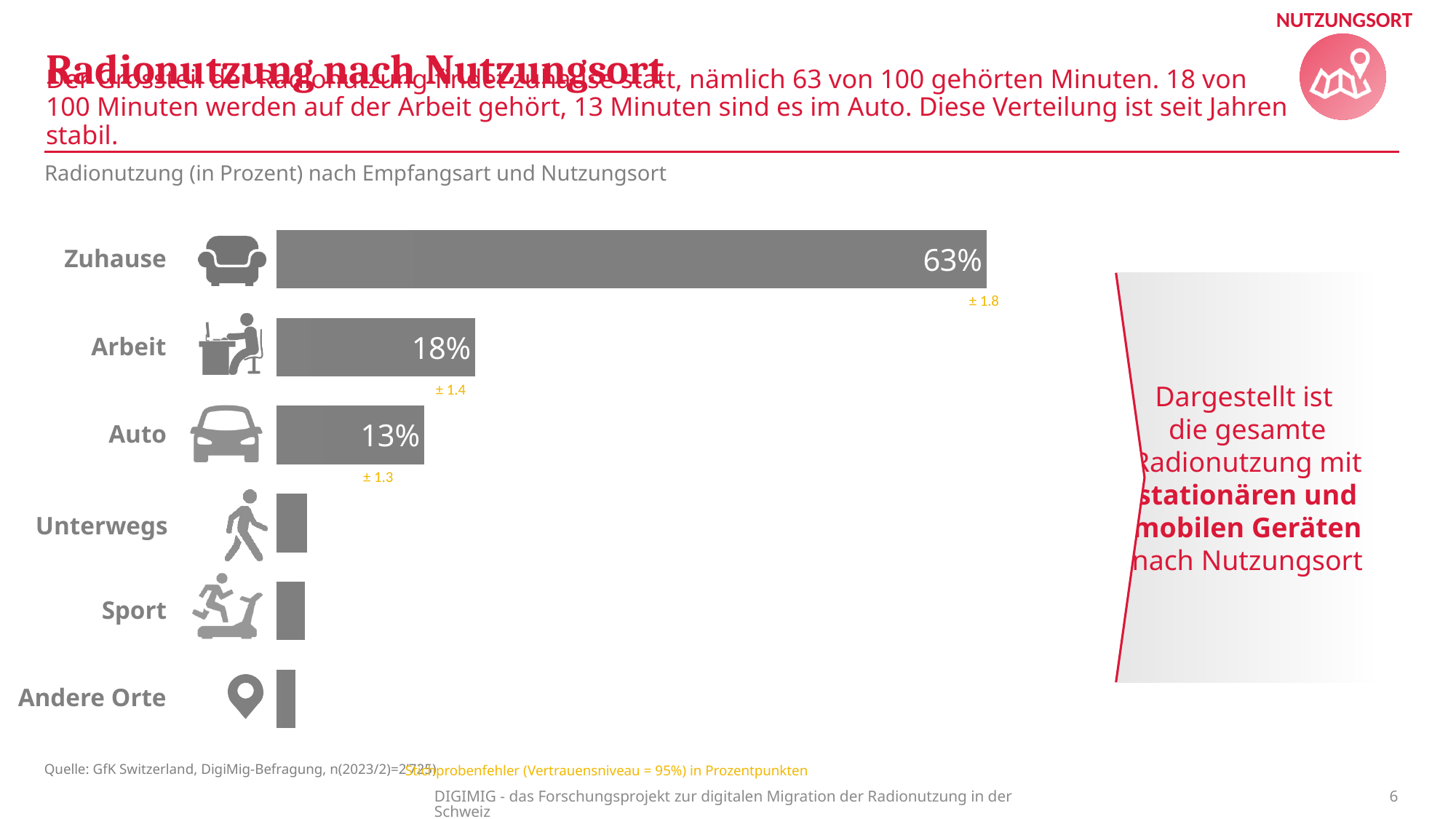
What is the sampling error (±) shown for the Zuhause bar? ± 1.8 Which category has the highest value? Zuhause Which is larger, the value for Arbeit or the value for Auto? Arbeit What is the difference between the values for Arbeit and Auto? 5% Which category has the lowest value? Andere Orte What kind of chart is shown on the slide? Bar chart Which is larger, the value for Unterwegs or the value for Andere Orte? Unterwegs What is the value for Auto? 13% What is the value for Arbeit? 18% What is the value for Zuhause? 63% What is the difference between the values for Zuhause and Arbeit? 45% How many categories are shown in the chart? 6